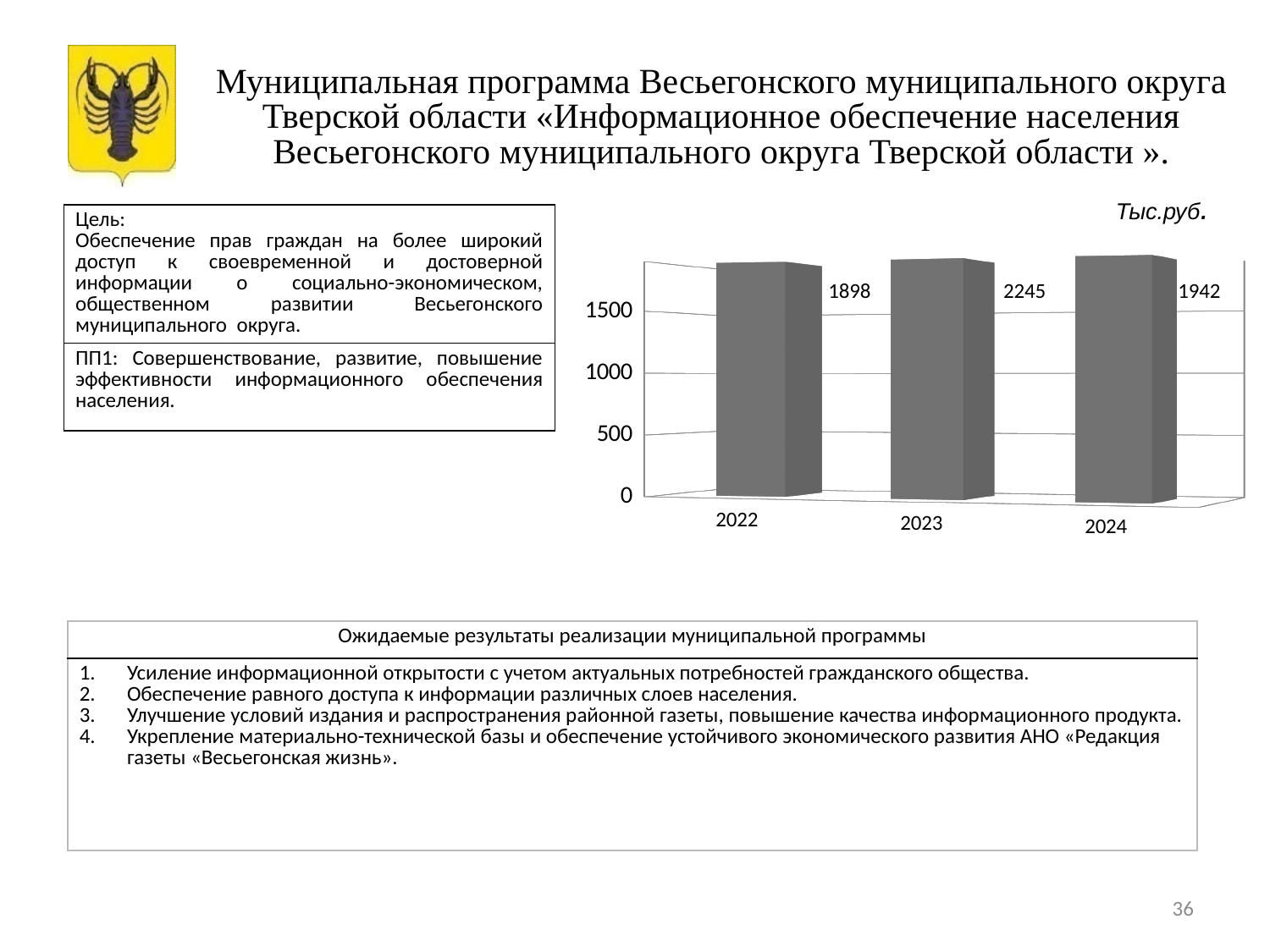
What unit is indicated above the chart? Тыс.руб. Is the value for 2023 greater or less than 2000? greater What kind of chart is shown on the slide? bar chart What is the value for 2023? 2245 How many years are shown on the chart? 3 What is the value for 2022? 1898 What is the difference between the values for 2023 and 2022? 347 Which year has the highest value? 2023 Which year has the lowest value? 2022 What is the value for 2024? 1942 Which is larger, the value for 2022 or the value for 2024? 2024 What is the difference between the values for 2023 and 2024? 303